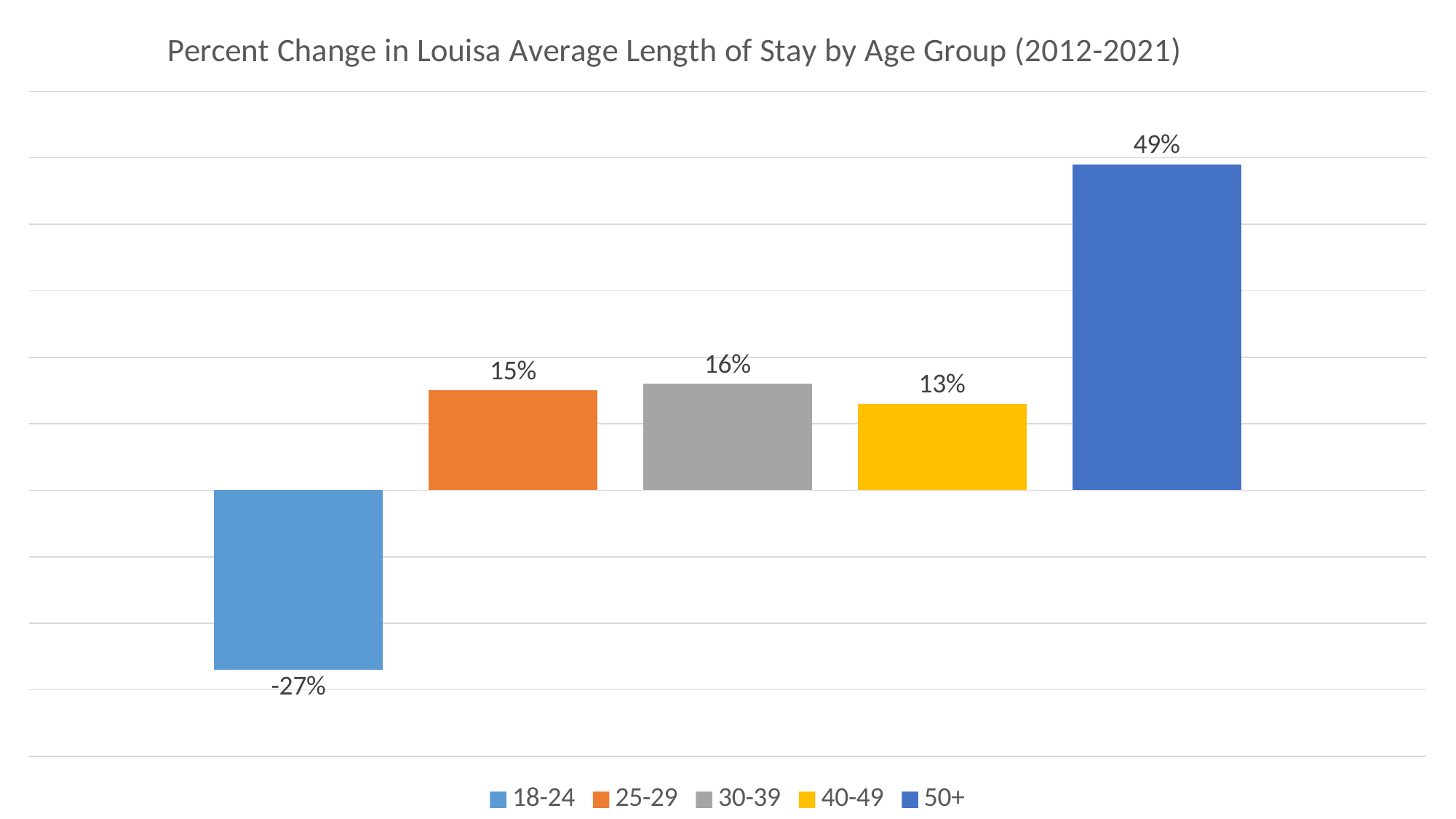
What is the percent change in average length of stay for the 30-39 age group? 16% What is the percent change in average length of stay for the 18-24 age group? -27% How many entries does the legend list? 5 Which age group has the lowest percent change in average length of stay? 18-24 What is the difference between the percent change for the 50+ group and the 25-29 group? 34% What is the title of the chart? Percent Change in Louisa Average Length of Stay by Age Group (2012-2021) How many age groups are shown in the chart? 5 What type of chart is shown on the slide? Bar chart What is the percent change in average length of stay for the 50+ age group? 49% What is the percent change in average length of stay for the 40-49 age group? 13% Which age group has the highest percent change in average length of stay? 50+ Which age group has a larger percent change, 25-29 or 40-49? 25-29